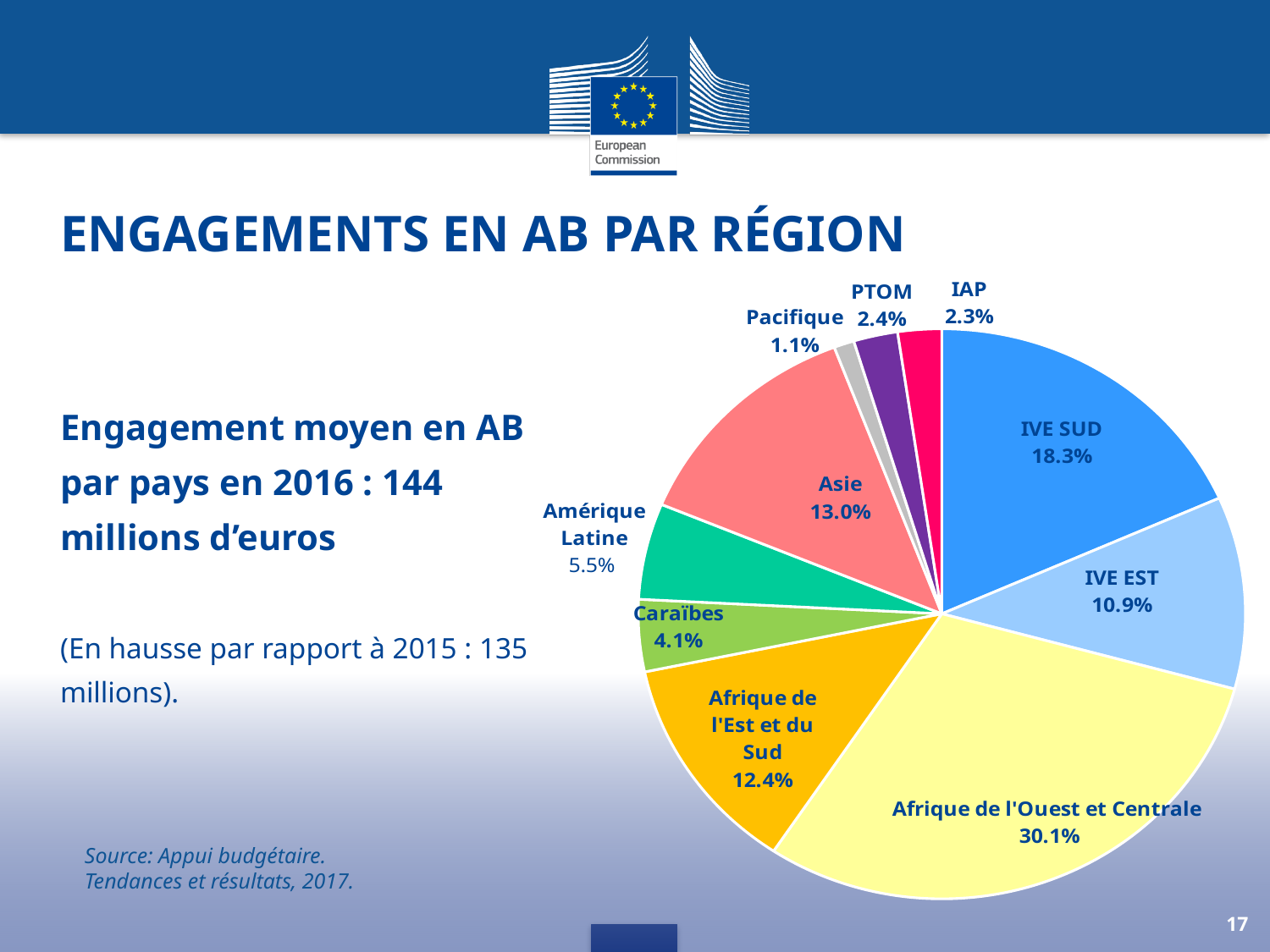
Which region has the smallest slice of the pie? Pacifique What is the title of the slide containing the chart? ENGAGEMENTS EN AB PAR RÉGION How many slices does the pie chart have? 10 Which region has the largest slice of the pie? Afrique de l'Ouest et Centrale What share of the pie does Afrique de l'Ouest et Centrale represent? 30.1% What is the value shown for Amérique Latine? 5.5% What type of chart is shown on the slide? Pie chart What is the combined share of PTOM and IAP? 4.7% What is the value shown for IVE SUD? 18.3% What is the difference in percentage points between IVE SUD and IVE EST? 7.4 What percentage is shown for Asie? 13.0% Which is larger, the share for Asie or the share for Afrique de l'Est et du Sud? Asie